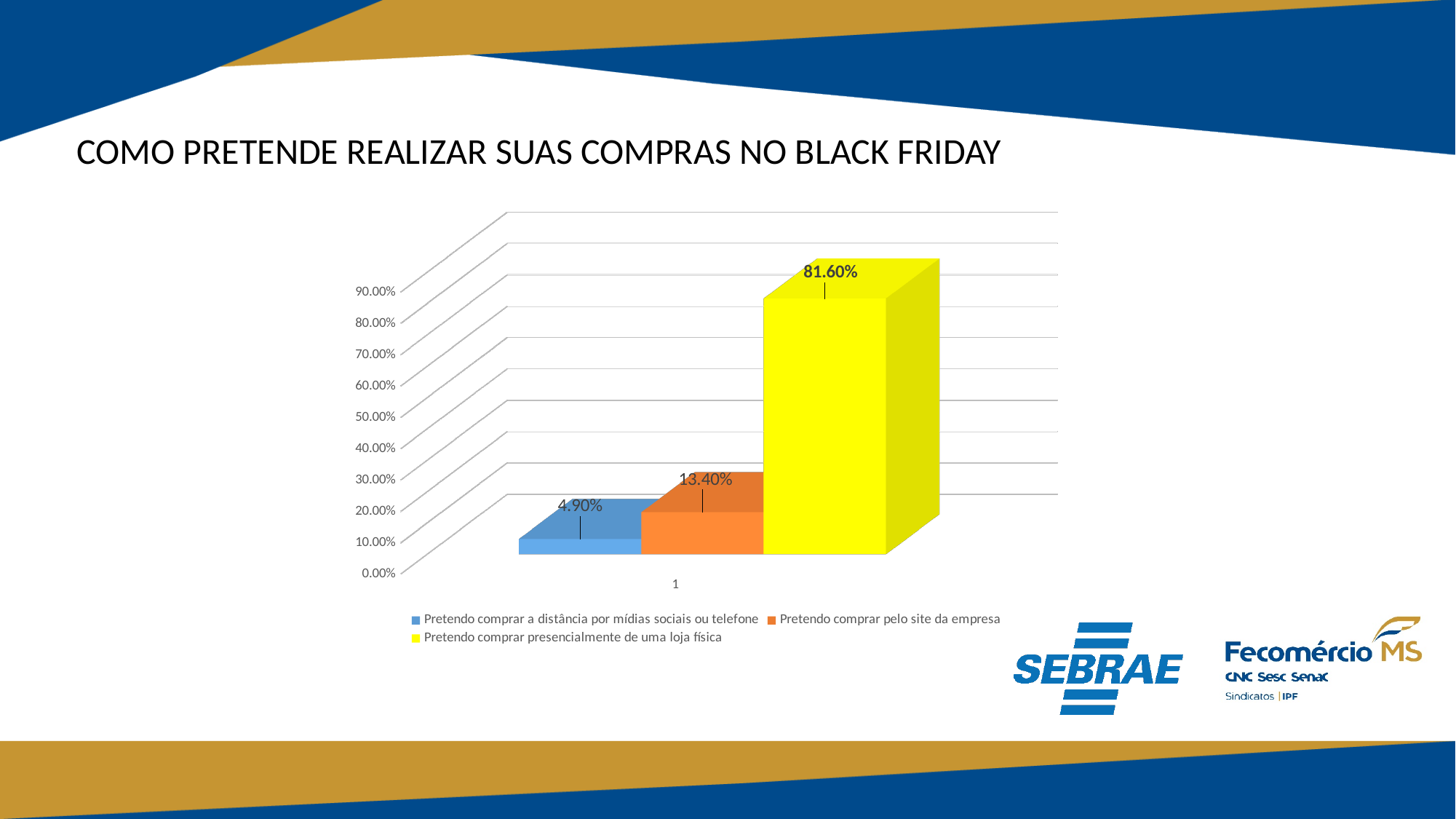
Which series has the highest value? Pretendo comprar presencialmente de uma loja física What kind of chart is shown on the slide? Bar chart What is the value for 'Pretendo comprar pelo site da empresa'? 13.40% What is the difference between the value for 'Pretendo comprar pelo site da empresa' and the value for 'Pretendo comprar a distância por mídias sociais ou telefone'? 8.50% Which is larger: the value for 'Pretendo comprar pelo site da empresa' or the value for 'Pretendo comprar a distância por mídias sociais ou telefone'? Pretendo comprar pelo site da empresa What is the value for 'Pretendo comprar presencialmente de uma loja física'? 81.60% What colour is the bar for 'Pretendo comprar presencialmente de uma loja física'? Yellow How many series does the legend list? 3 Which series has the lowest value? Pretendo comprar a distância por mídias sociais ou telefone What is the title of the slide? COMO PRETENDE REALIZAR SUAS COMPRAS NO BLACK FRIDAY What is the difference between the value for 'Pretendo comprar presencialmente de uma loja física' and the value for 'Pretendo comprar pelo site da empresa'? 68.20% What is the value for 'Pretendo comprar a distância por mídias sociais ou telefone'? 4.90%